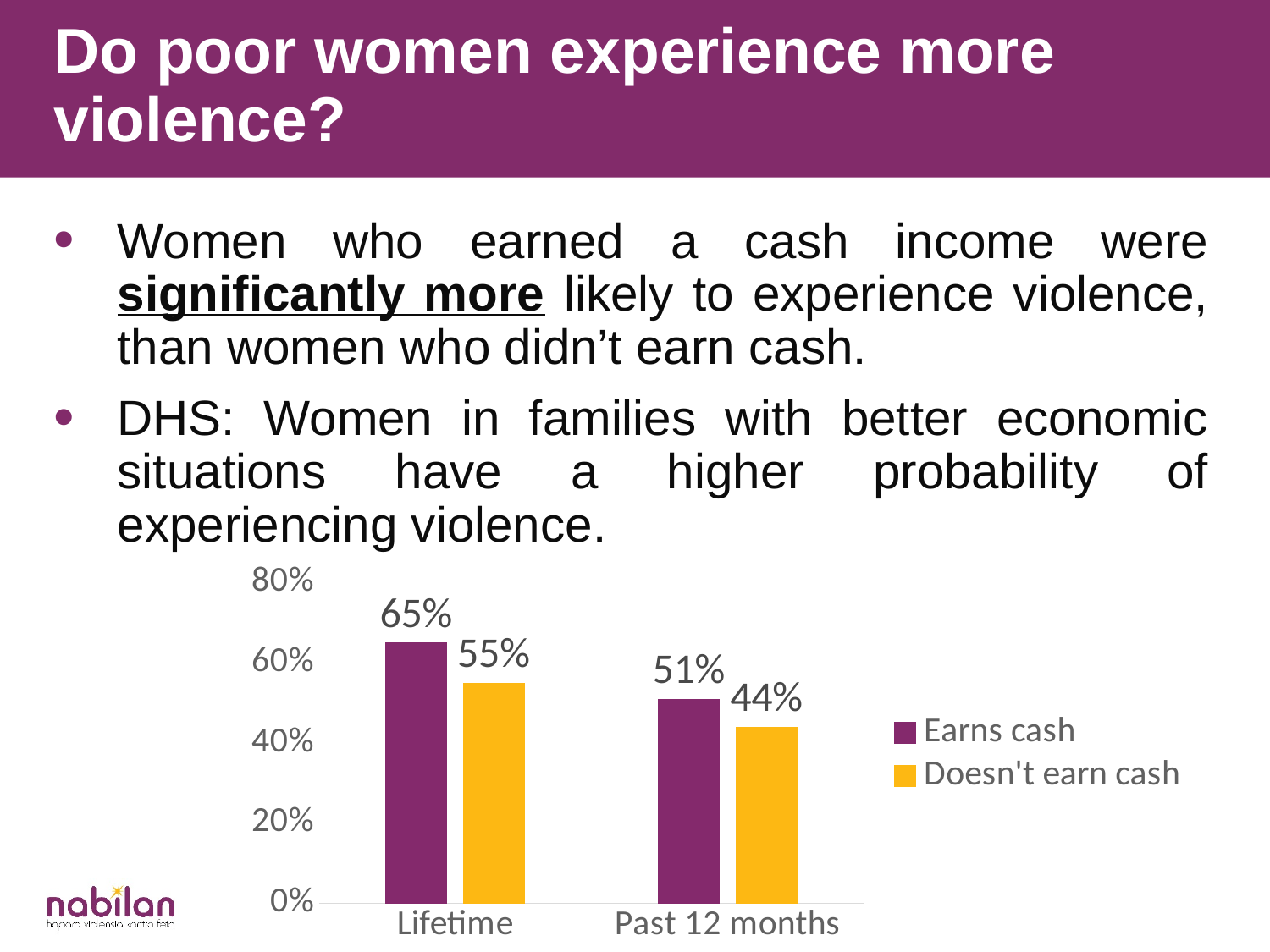
How many categories are shown on the x axis of the chart? 2 What is the difference between Earns cash and Doesn't earn cash in the Past 12 months category? 7% In the Past 12 months category, which is larger: Earns cash or Doesn't earn cash? Earns cash What kind of chart is shown on the slide? Bar chart What is the value for Earns cash in the Lifetime category? 65% How many series does the chart's legend list? 2 What is the value for Earns cash in the Past 12 months category? 51% What is the value for Doesn't earn cash in the Lifetime category? 55% Which bar has the lowest value on the chart? Doesn't earn cash, Past 12 months What is the difference between Earns cash and Doesn't earn cash in the Lifetime category? 10% Which bar has the highest value on the chart? Earns cash, Lifetime What is the value for Doesn't earn cash in the Past 12 months category? 44%